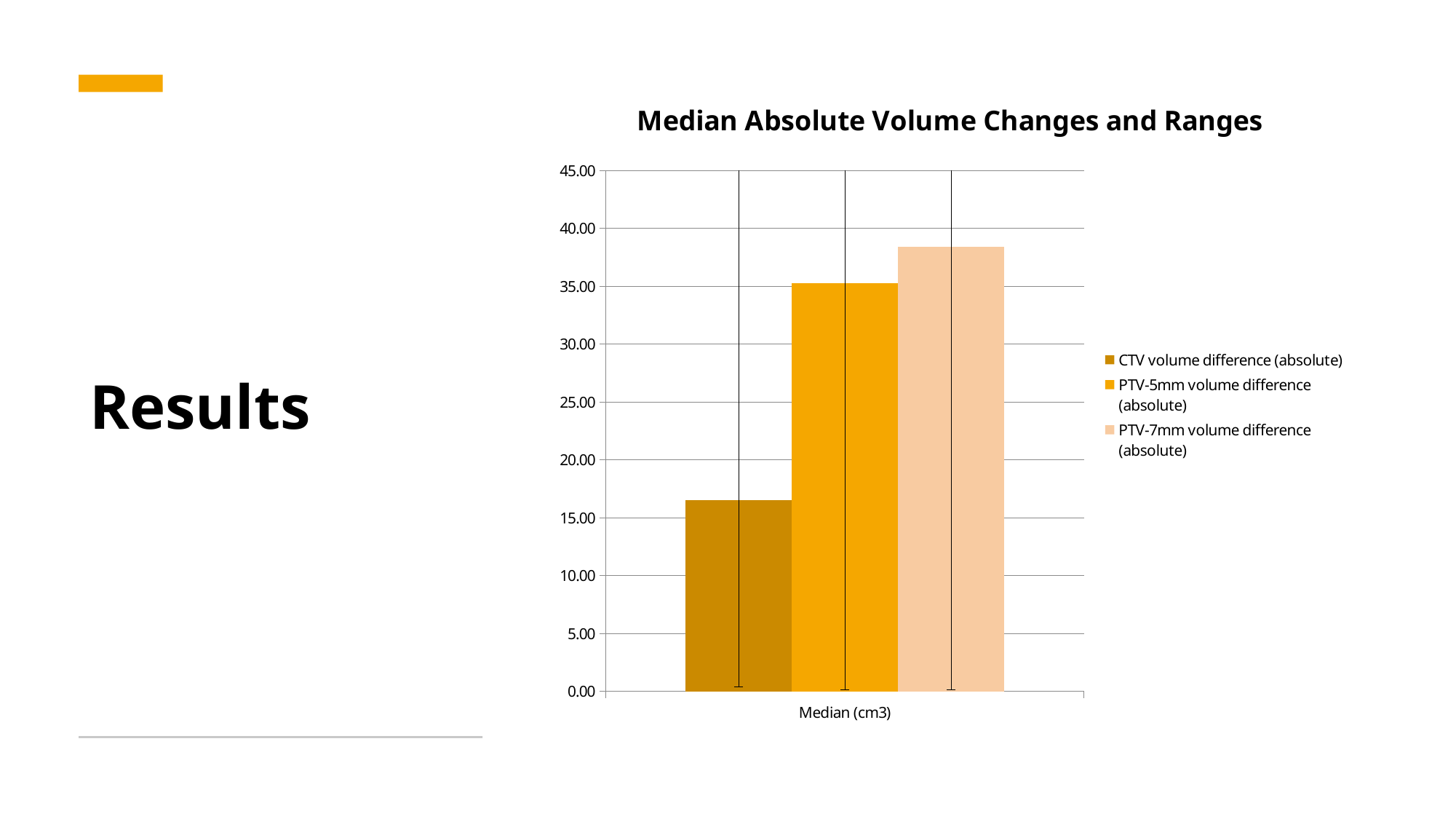
Which series has the highest median value? PTV-7mm volume difference (absolute) Is the value for CTV volume difference (absolute) greater or less than 15.00? greater Which is larger, the value for PTV-5mm volume difference (absolute) or CTV volume difference (absolute)? PTV-5mm volume difference (absolute) How many categories are shown on the x axis? 1 Is the value for CTV volume difference (absolute) greater or less than 20.00? less What is the label on the x axis category? Median (cm3) How many series does the legend list? 3 Which series has the lowest median value? CTV volume difference (absolute) What is the title of the chart? Median Absolute Volume Changes and Ranges Is the value for PTV-7mm volume difference (absolute) greater or less than 40.00? less What kind of chart is shown on the slide? bar chart